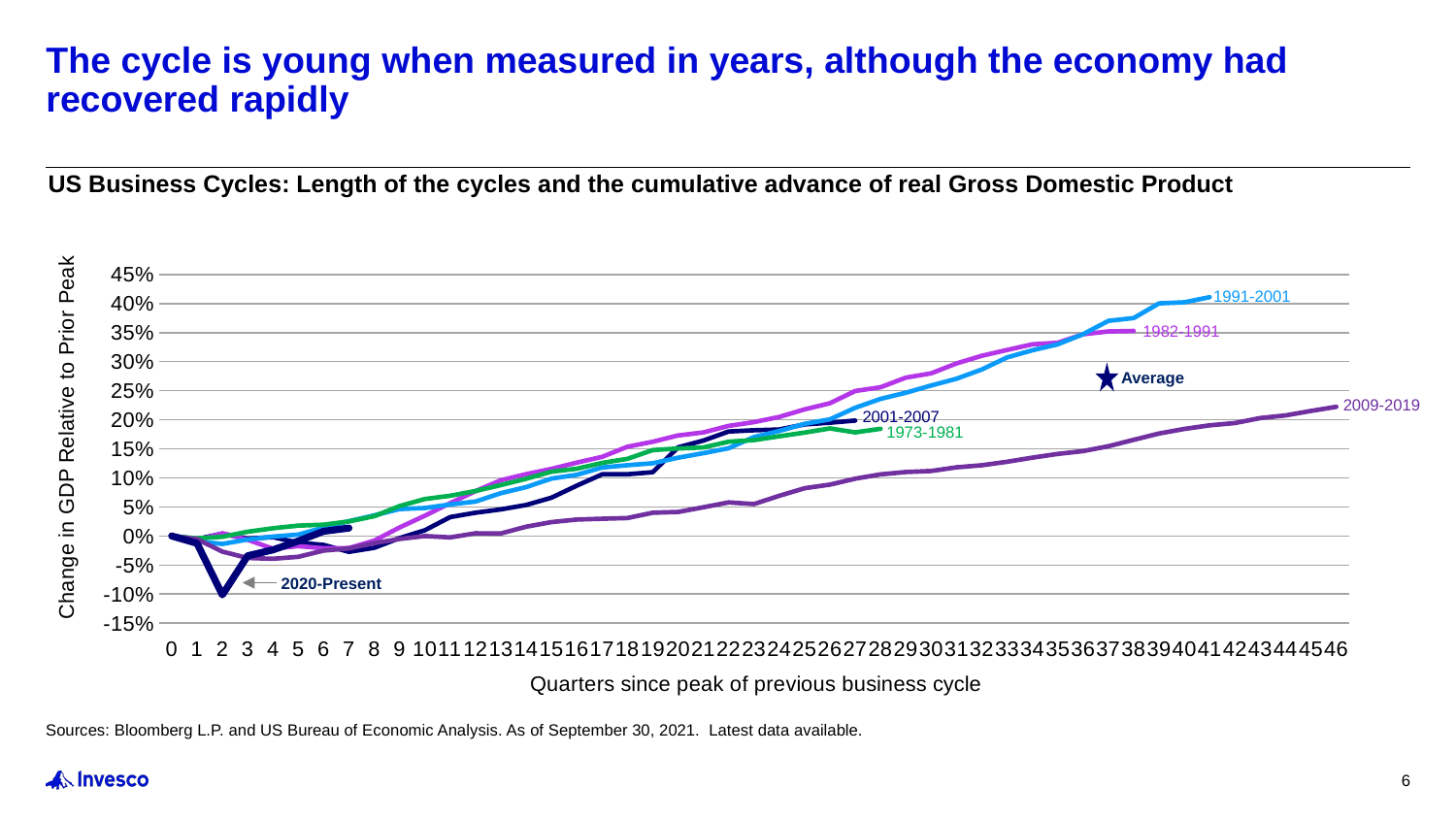
How many business cycle periods are labeled as lines on the chart? 6 Which business cycle line dips to the lowest value on the chart? 2020-Present Is the lowest point of the 2020-Present line greater or less than -5%? less Which business cycle line extends the furthest along the x axis (lasted the most quarters)? 2009-2019 What is the label of the x axis? Quarters since peak of previous business cycle At their end points, which line is higher: 1991-2001 or 2009-2019? 1991-2001 Which business cycle line reaches the highest change in GDP relative to prior peak? 1991-2001 What kind of chart is shown on the slide? Line chart What is the title of the chart? US Business Cycles: Length of the cycles and the cumulative advance of real Gross Domestic Product Is the final value of the 2009-2019 line greater or less than 20%? greater Does the 2009-2019 line generally rise or fall as quarters since the peak increase? Rise Is the final value of the 1991-2001 line greater or less than 35%? greater